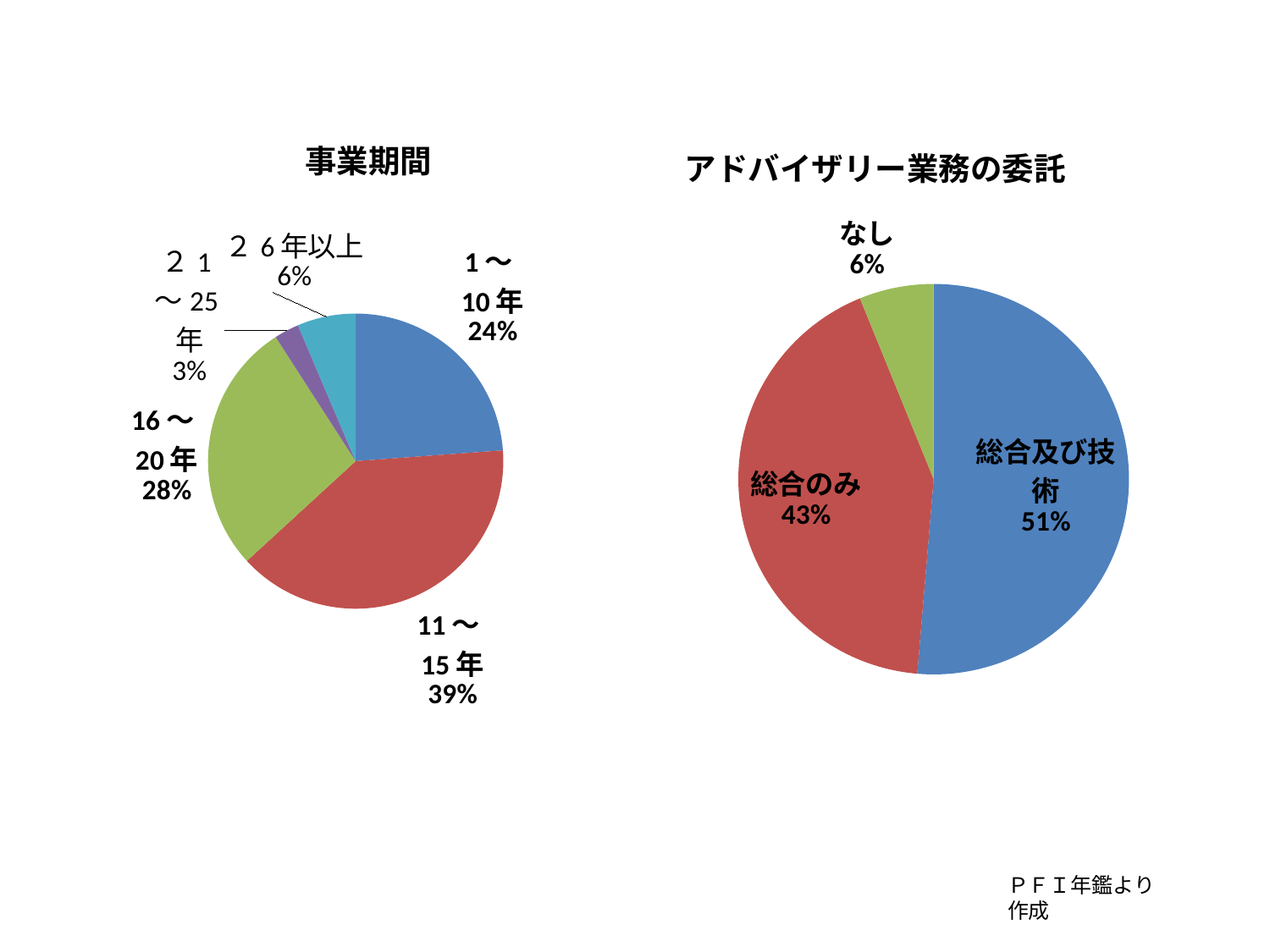
What type of chart is the アドバイザリー業務の委託 chart? Pie chart In the 事業期間 chart, what share does the 11～15年 slice have? 39% In the 事業期間 chart, how many slices are there? 5 In the アドバイザリー業務の委託 chart, how many slices are there? 3 In the アドバイザリー業務の委託 chart, what share does 総合のみ have? 43% In the アドバイザリー業務の委託 chart, which category has the largest share? 総合及び技術 In the 事業期間 chart, what share does the 1～10年 slice have? 24% In the 事業期間 chart, which category has the largest share? 11～15年 In the 事業期間 chart, which is larger, 1～10年 or 16～20年? 16～20年 In the アドバイザリー業務の委託 chart, what is the difference in percentage points between 総合及び技術 and 総合のみ? 8 In the 事業期間 chart, which category has the smallest share? 21～25年 In the 事業期間 chart, what is the difference in percentage points between 16～20年 and 26年以上? 22